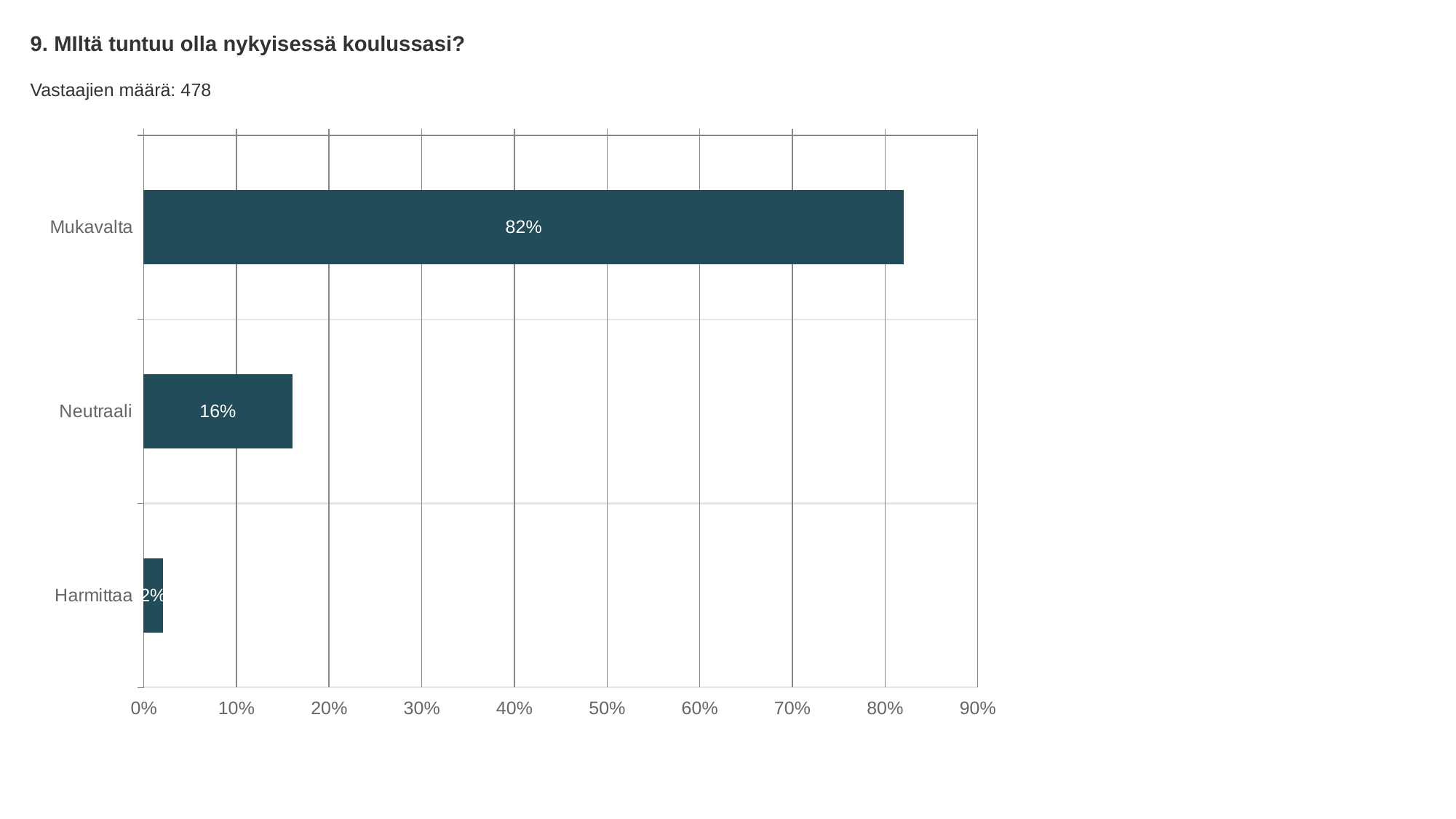
How many categories are shown in the chart? 3 What is the difference between the values for Neutraali and Harmittaa? 14% What is the difference between the values for Mukavalta and Neutraali? 66% What is the value for Mukavalta? 82% Which category has the highest value? Mukavalta Which is larger, the value for Neutraali or the value for Harmittaa? Neutraali What is the value for Neutraali? 16% Which category has the lowest value? Harmittaa Is the value for Mukavalta greater or less than 80%? greater What is the value for Harmittaa? 2% What kind of chart is shown on the slide? bar chart How many respondents (Vastaajien määrä) are reported on the slide? 478